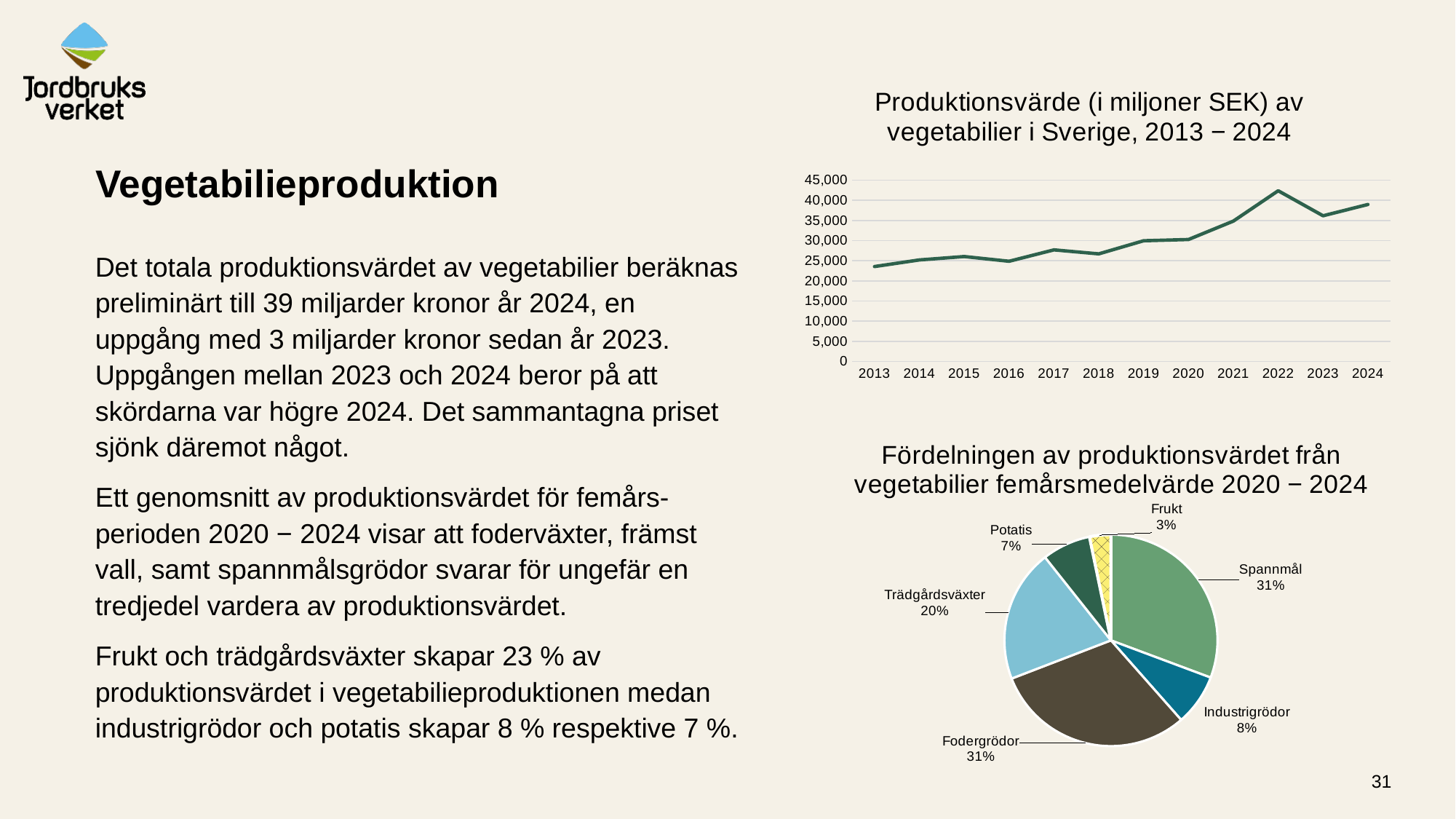
In the top line chart, which year has the highest value? 2022 In the top line chart, is the value for 2024 greater or less than 40,000? less In the top line chart, is the value for 2022 greater or less than 40,000? greater In the bottom pie chart, how many slices are there? 6 In the bottom pie chart, which category has the smallest share? Frukt In the bottom pie chart, what share does Trädgårdsväxter have? 20% In the bottom pie chart, what is the difference between the shares of Trädgårdsväxter and Industrigrödor? 12% In the top line chart, does the value rise or fall between 2022 and 2023? fall In the top line chart, is the value for 2013 greater or less than 25,000? less What kind of chart is the bottom chart titled "Fördelningen av produktionsvärdet från vegetabilier femårsmedelvärde 2020 − 2024"? pie chart In the top line chart, how many years are shown on the x axis? 12 What kind of chart is the top chart titled "Produktionsvärde (i miljoner SEK) av vegetabilier i Sverige, 2013 − 2024"? line chart